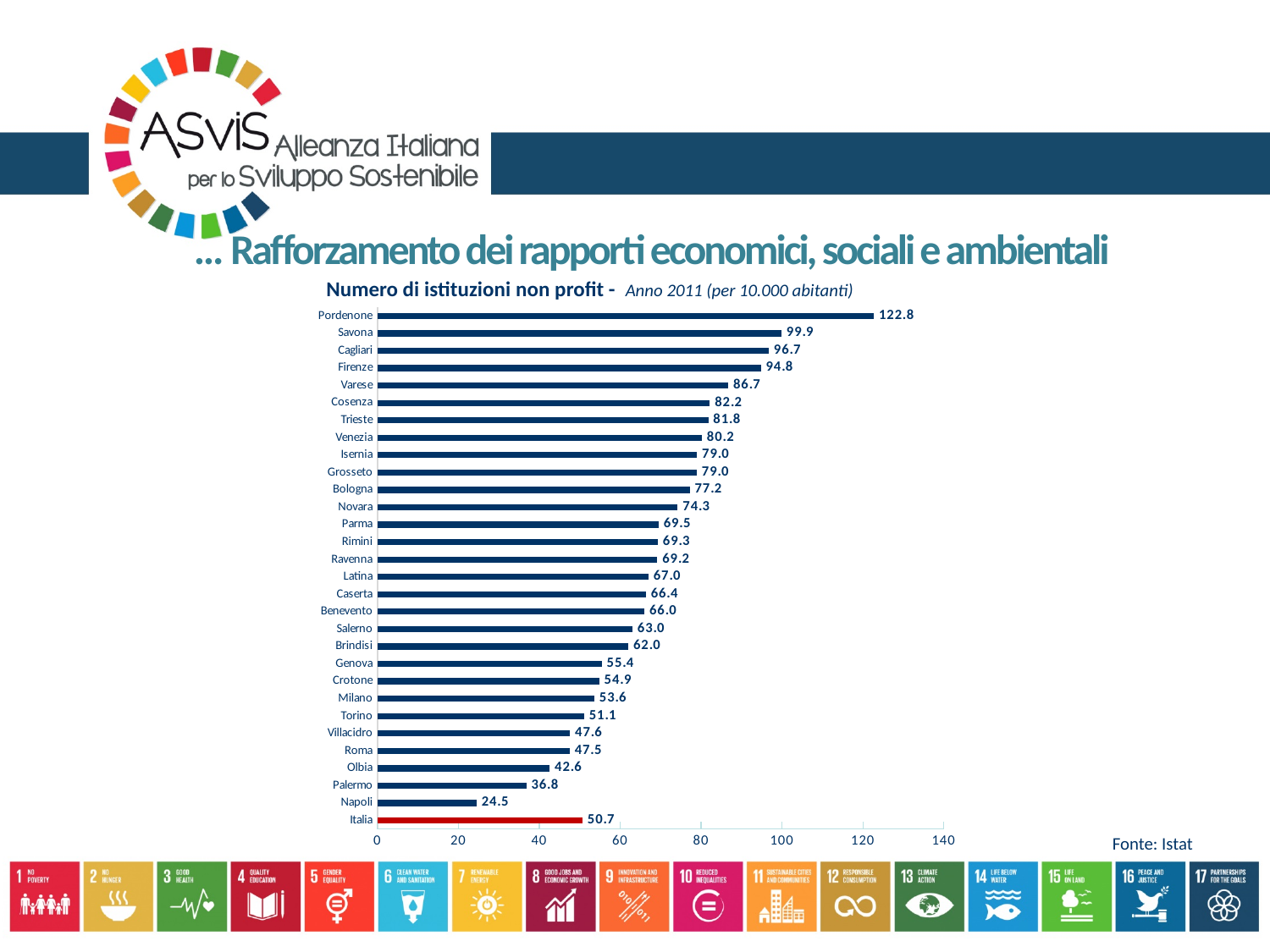
What is the value for Pordenone? 122.8 What is the difference between the values for Pordenone and Savona? 22.9 What is the difference between the values for Italia and Napoli? 26.2 Which category has the highest value? Pordenone What is the title of the chart? Numero di istituzioni non profit - Anno 2011 (per 10.000 abitanti) How many categories are shown in the chart? 30 What kind of chart is shown on the slide? Bar chart Is the value for Firenze greater or less than 100? less What is the value for Italia? 50.7 What is the value for Napoli? 24.5 Which category has the lowest value? Napoli Which has a larger value, Milano or Roma? Milano